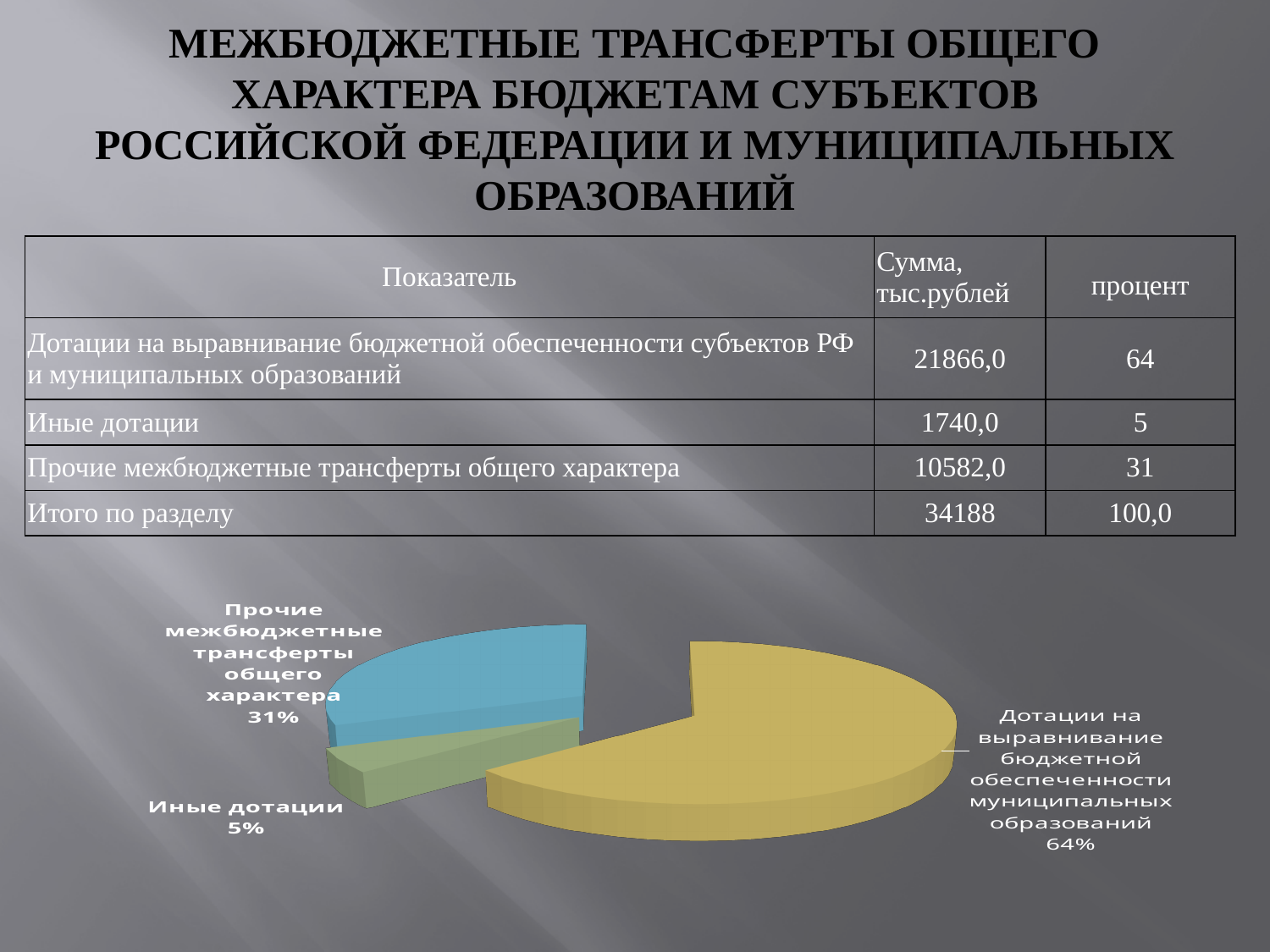
What share of the pie does "Иные дотации" represent? 5% What is the difference in percentage points between the "Дотации на выравнивание бюджетной обеспеченности муниципальных образований" slice and the "Прочие межбюджетные трансферты общего характера" slice? 33 What is the difference in percentage points between the "Прочие межбюджетные трансферты общего характера" slice and the "Иные дотации" slice? 26 What colour is the largest slice of the pie chart? Yellow What colour is the "Иные дотации" slice in the pie chart? Green Which is larger in the pie chart: "Иные дотации" or "Прочие межбюджетные трансферты общего характера"? Прочие межбюджетные трансферты общего характера What kind of chart is shown on the slide? Pie chart Which slice of the pie chart is the largest? Дотации на выравнивание бюджетной обеспеченности муниципальных образований What share of the pie does "Прочие межбюджетные трансферты общего характера" represent? 31% How many slices does the pie chart have? 3 What share of the pie does "Дотации на выравнивание бюджетной обеспеченности муниципальных образований" represent? 64% Which slice of the pie chart is the smallest? Иные дотации